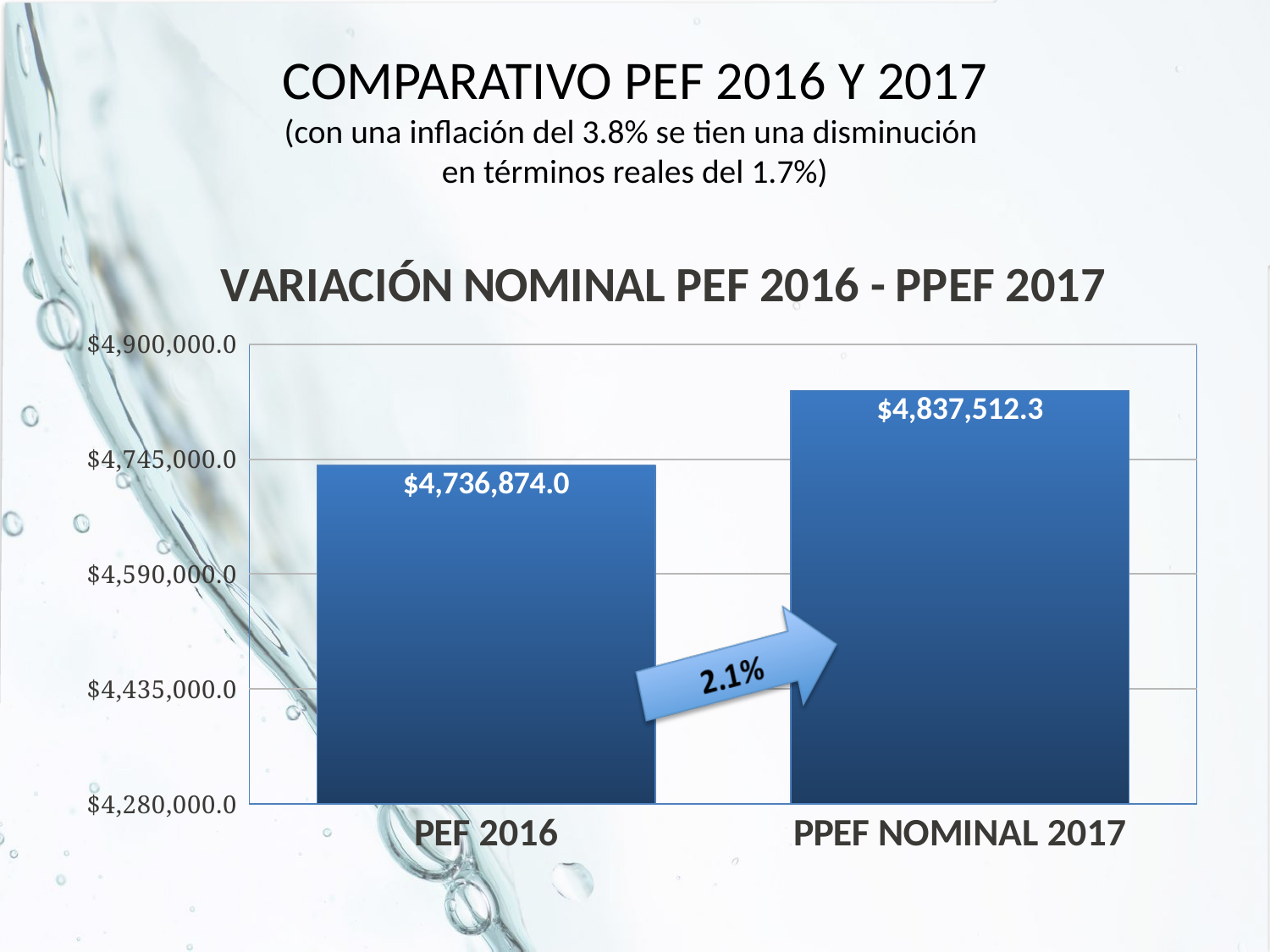
Which category has the lowest value? PEF 2016 Is the value for PEF 2016 greater or less than $4,590,000.0? greater Which category has the highest value? PPEF NOMINAL 2017 What is the value for PEF 2016? $4,736,874.0 What is the difference between the values for PPEF NOMINAL 2017 and PEF 2016? $100,638.3 Do the values rise or fall from PEF 2016 to PPEF NOMINAL 2017? Rise What is the title of the chart? VARIACIÓN NOMINAL PEF 2016 - PPEF 2017 Is the value for PPEF NOMINAL 2017 greater or less than $4,745,000.0? greater What kind of chart is shown on the slide? Bar chart How many categories are shown in the chart? 2 What is the value for PPEF NOMINAL 2017? $4,837,512.3 Which is larger, the value for PEF 2016 or the value for PPEF NOMINAL 2017? PPEF NOMINAL 2017